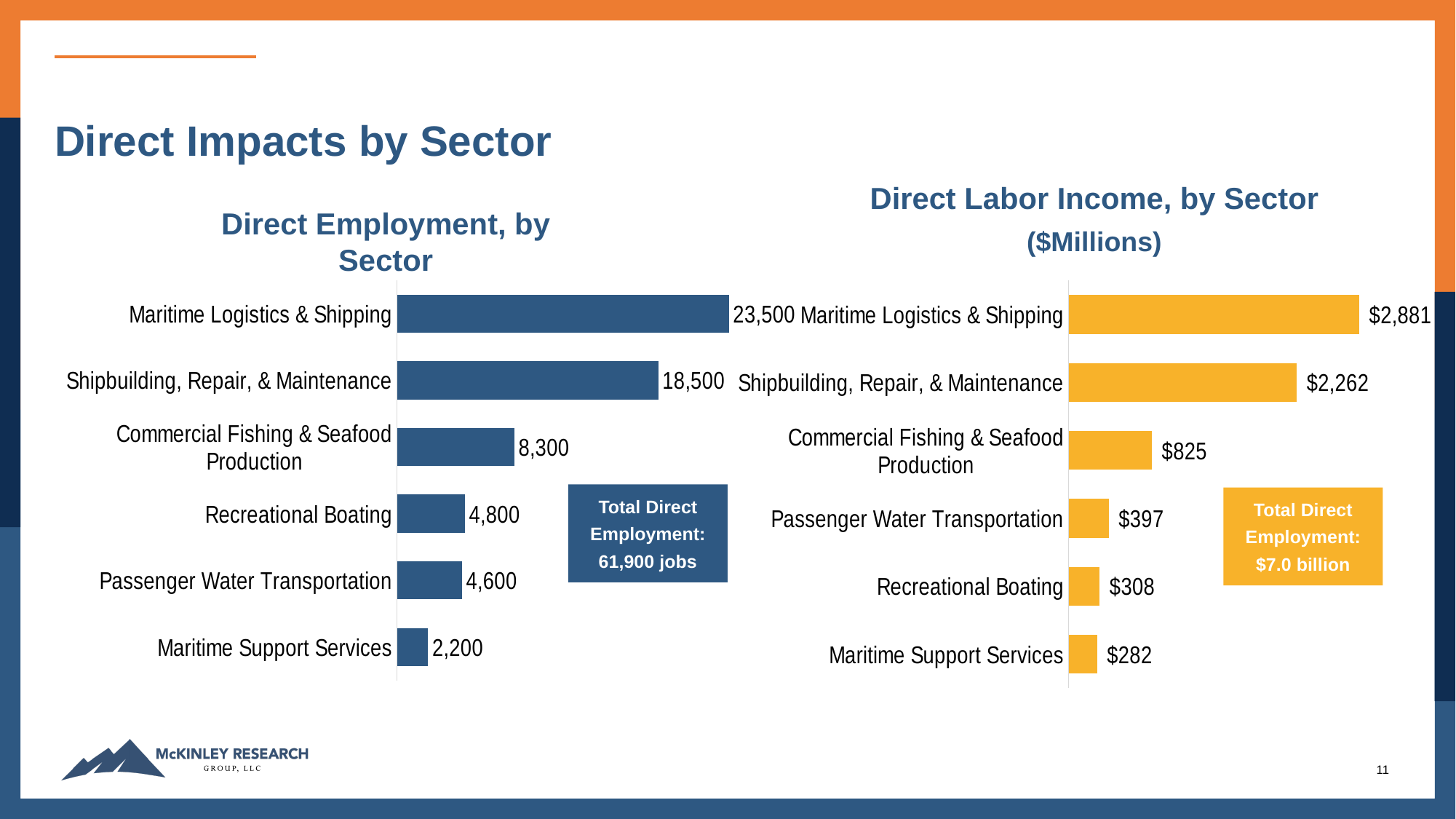
What type of chart is the Direct Labor Income, by Sector chart? Bar chart In the Direct Employment, by Sector chart, what is the difference between Maritime Logistics & Shipping and Shipbuilding, Repair, & Maintenance? 5,000 In the Direct Labor Income, by Sector chart, which sector has the lowest value? Maritime Support Services What unit is stated in the title of the Direct Labor Income, by Sector chart? $Millions In the Direct Labor Income, by Sector chart, what is the difference between Passenger Water Transportation and Recreational Boating? $89 In the Direct Labor Income, by Sector chart, what is the value for Maritime Logistics & Shipping? $2,881 In the Direct Employment, by Sector chart, which is larger: Recreational Boating or Passenger Water Transportation? Recreational Boating In the Direct Employment, by Sector chart, what is the value for Shipbuilding, Repair, & Maintenance? 18,500 In the Direct Employment, by Sector chart, which sector has the highest value? Maritime Logistics & Shipping In the Direct Labor Income, by Sector chart, which is larger: Recreational Boating or Passenger Water Transportation? Passenger Water Transportation How many sectors are shown in the Direct Employment, by Sector chart? 6 In the Direct Labor Income, by Sector chart, what is the value for Commercial Fishing & Seafood Production? $825